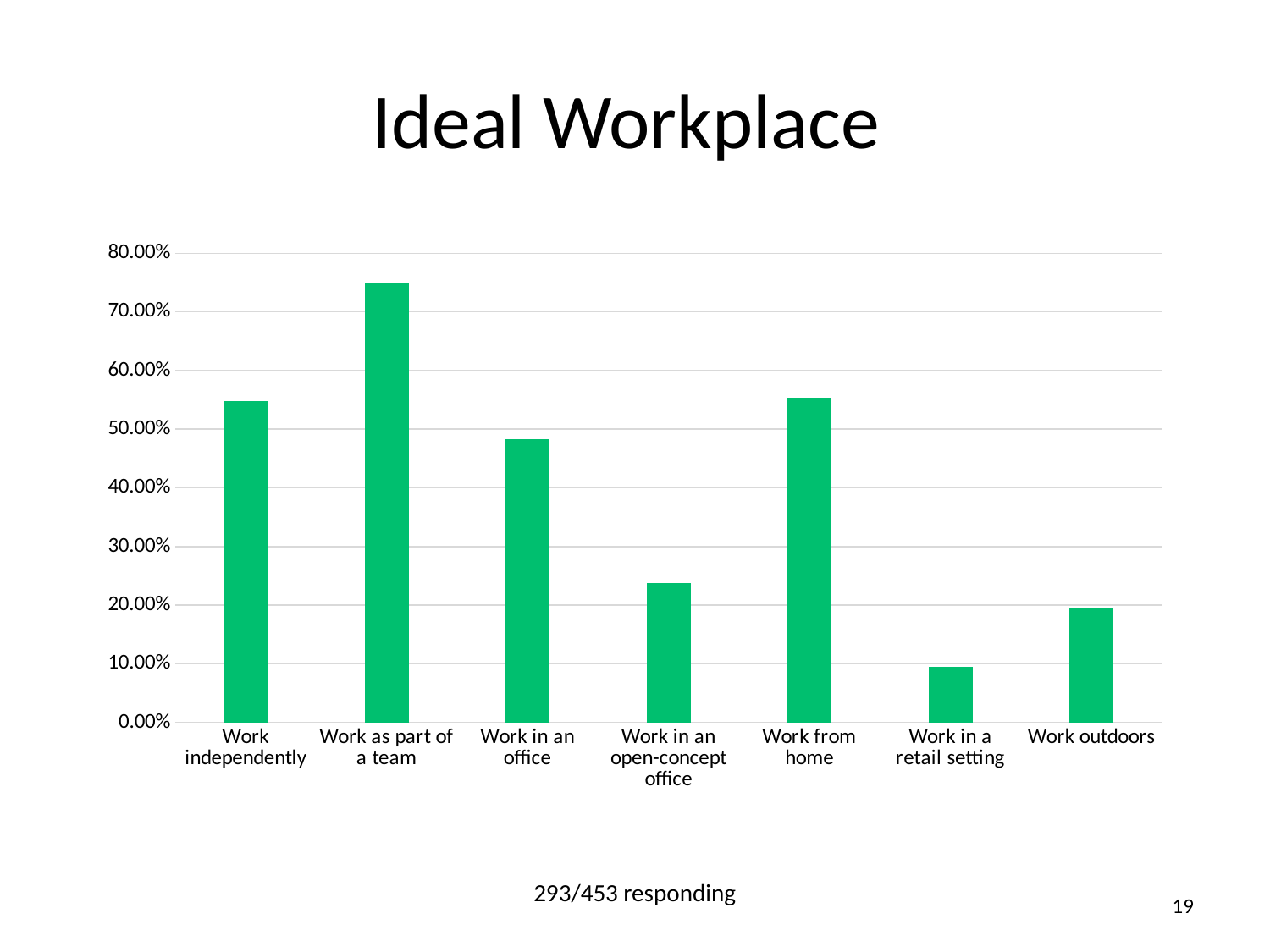
Which is larger, the value for Work outdoors or the value for Work from home? Work from home How many categories are shown on the x axis of the chart? 7 Which is larger, the value for Work in an office or the value for Work in an open-concept office? Work in an office Which category has the lowest value? Work in a retail setting Is the value for Work in an office greater or less than 50.00%? less Which category has the highest value? Work as part of a team Is the value for Work as part of a team greater or less than 70.00%? greater Is the value for Work outdoors greater or less than 10.00%? greater What is the title of the chart? Ideal Workplace What kind of chart is shown on the slide? bar chart